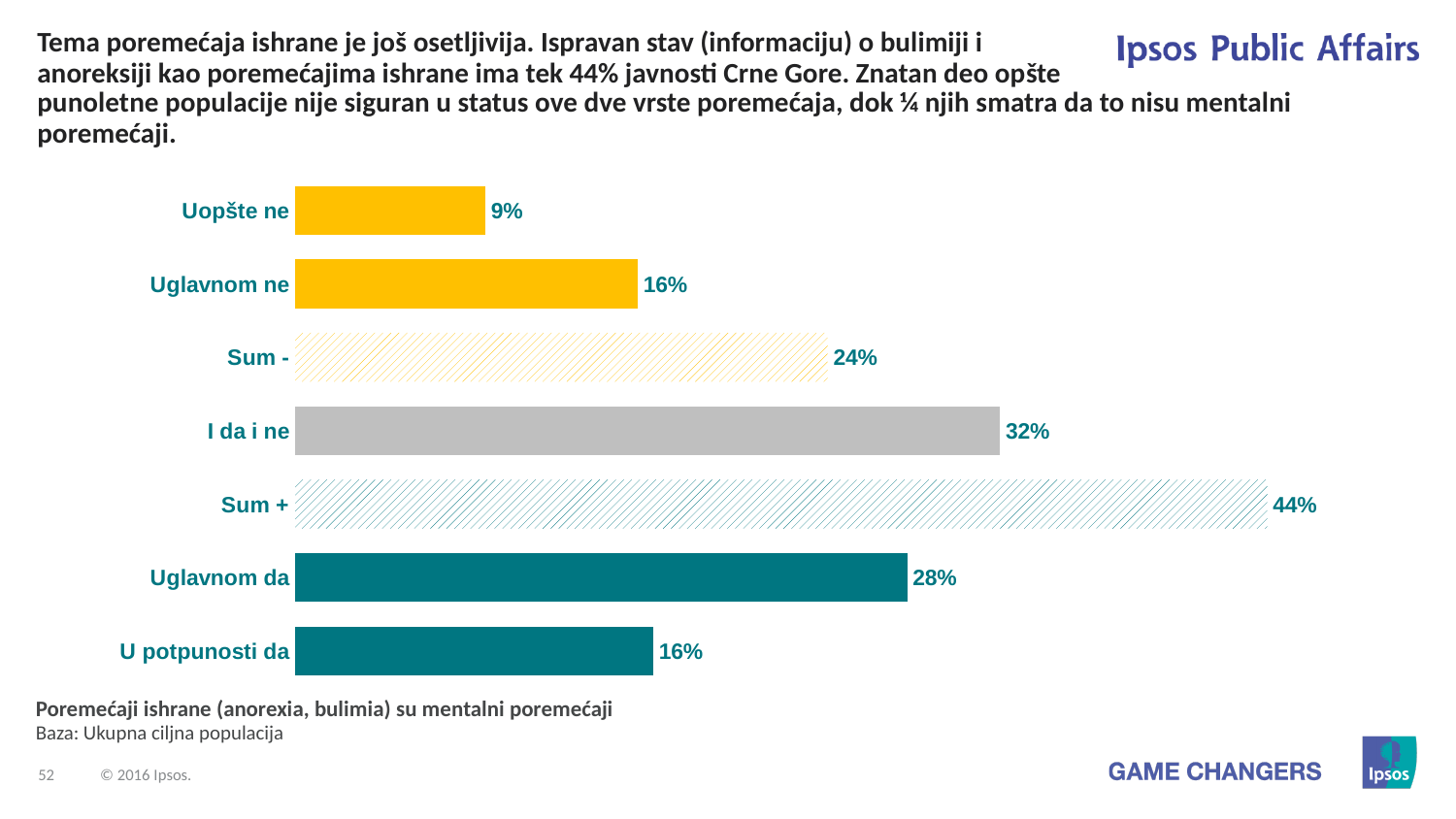
What is the value for "Uopšte ne"? 9% What is the difference between the values for "I da i ne" and "U potpunosti da"? 16% Which category has the lowest value? Uopšte ne What kind of chart is shown on the slide? Bar chart What is the value for "I da i ne"? 32% How many categories are shown in the chart? 7 What is the value for "Sum +"? 44% What is the difference between the values for "Sum +" and "Sum -"? 20% Which category has the highest value? Sum + Which two categories share the same value of 16%? Uglavnom ne and U potpunosti da What is the value for "Uglavnom da"? 28% Which is larger, the value for "Uglavnom da" or the value for "Uglavnom ne"? Uglavnom da